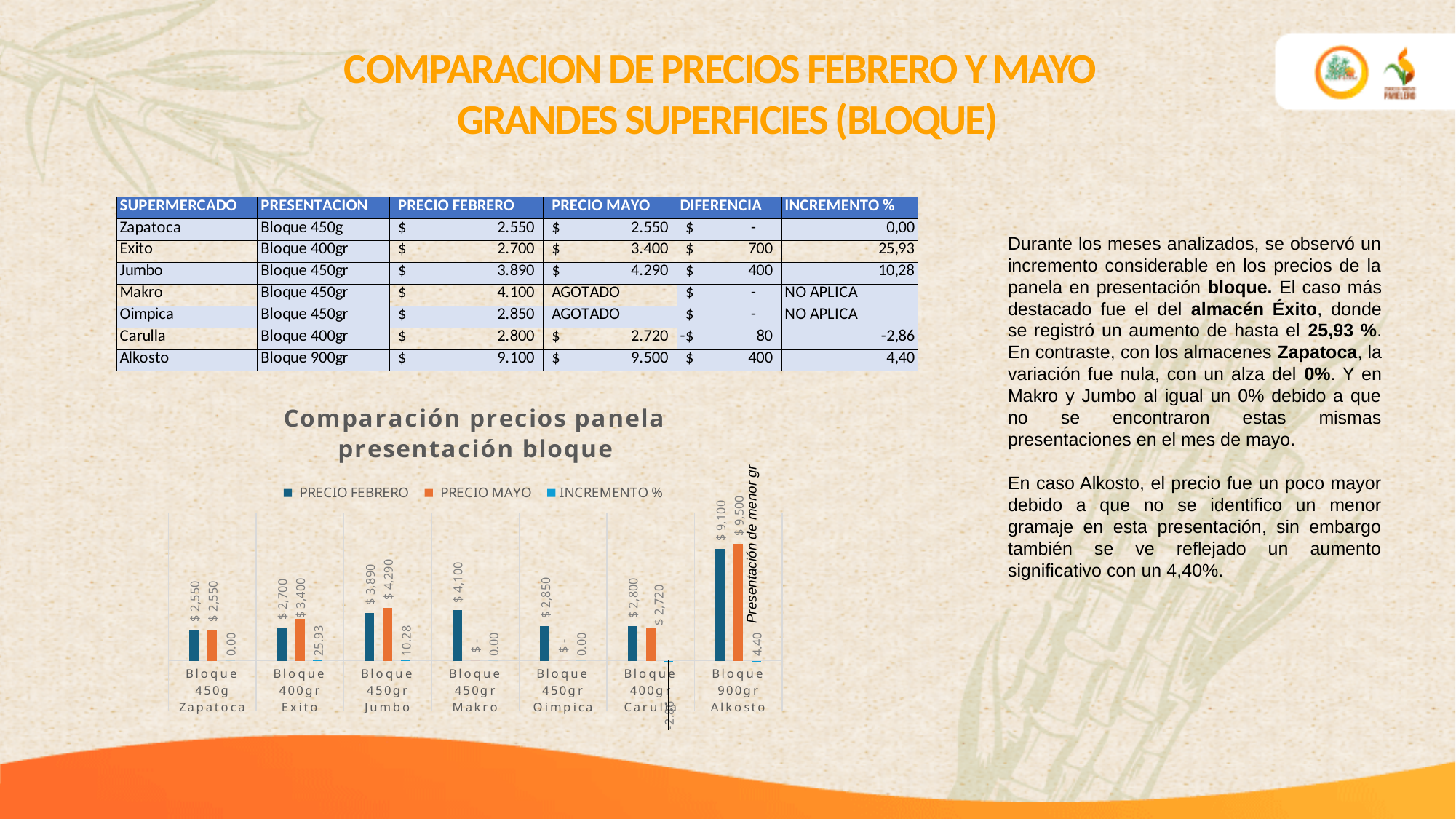
What is the PRECIO MAYO value for Bloque 400gr Exito in the chart? $ 3,400 What is the difference between PRECIO MAYO and PRECIO FEBRERO for Bloque 900gr Alkosto in the chart? $ 400 What kind of chart is shown on the slide? bar chart What is the PRECIO FEBRERO value for Bloque 900gr Alkosto in the chart? $ 9,100 Which category has the lowest PRECIO FEBRERO value in the chart? Bloque 450g Zapatoca What is the PRECIO MAYO value for Bloque 450gr Jumbo in the chart? $ 4,290 How many categories are shown along the x axis of the chart? 7 Which category has the highest PRECIO FEBRERO value in the chart? Bloque 900gr Alkosto For Bloque 450gr Jumbo, which is larger in the chart: PRECIO FEBRERO or PRECIO MAYO? PRECIO MAYO What is the title of the chart? Comparación precios panela presentación bloque What is the INCREMENTO % value for Bloque 400gr Exito in the chart? 25.93 How many series does the legend of the chart list? 3